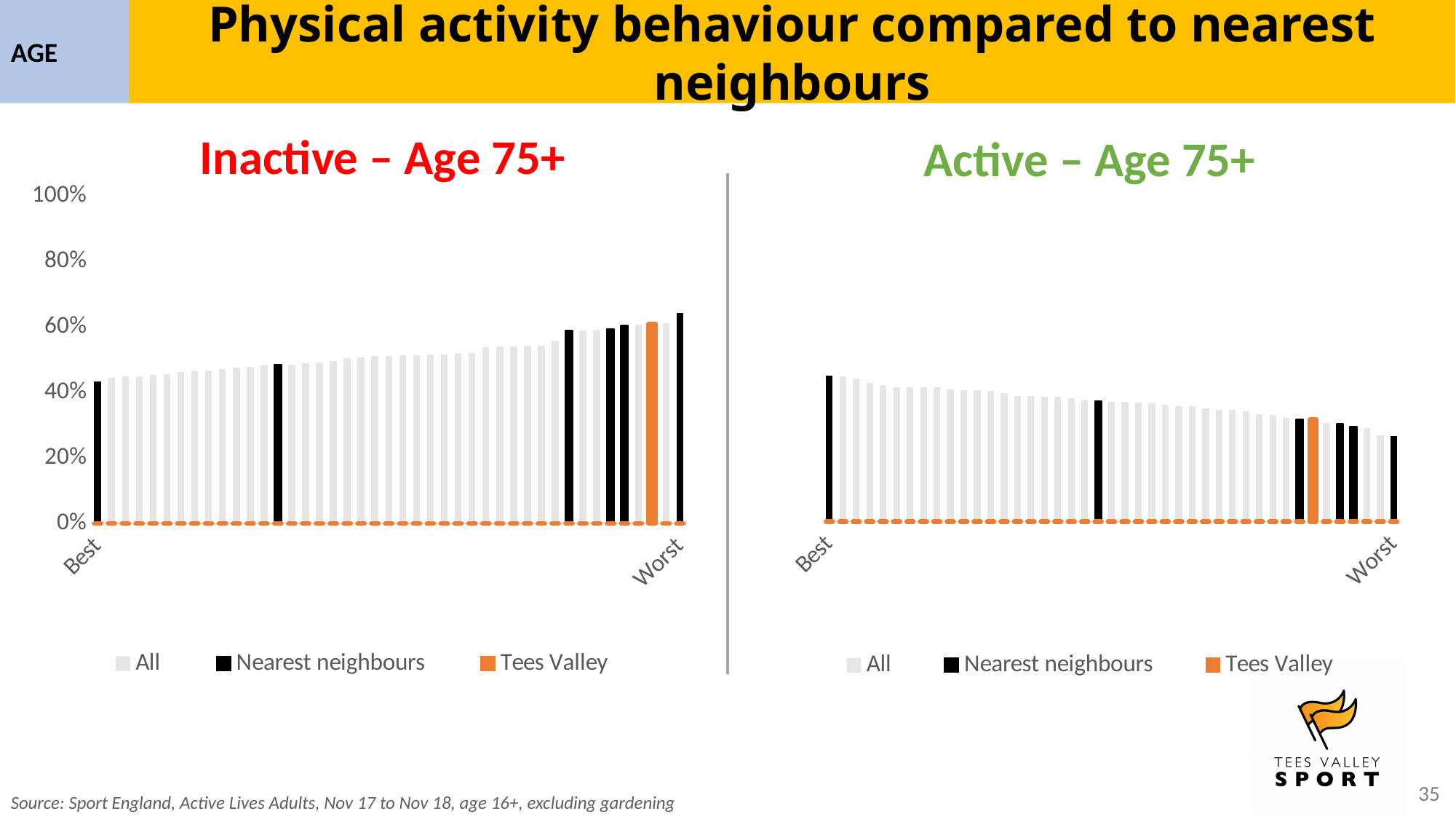
Which is larger: the Tees Valley value in the 'Inactive – Age 75+' chart or the Tees Valley value in the 'Active – Age 75+' chart? Inactive – Age 75+ What kind of chart is the 'Inactive – Age 75+' chart? bar chart In the 'Inactive – Age 75+' chart, do the values rise or fall from Best to Worst along the x axis? rise In the 'Active – Age 75+' chart, do the values rise or fall from Best to Worst along the x axis? fall In the 'Active – Age 75+' chart, is the Tees Valley value greater or less than 20%? greater What are the labels at the two ends of the x axis in the 'Active – Age 75+' chart? Best and Worst In the 'Inactive – Age 75+' chart, is the Tees Valley value greater or less than 40%? greater In the 'Inactive – Age 75+' chart, which colour represents the Tees Valley series? orange In the 'Inactive – Age 75+' chart, is the value of the bar at the Worst end greater or less than 60%? greater How many series does the legend of the 'Active – Age 75+' chart list? 3